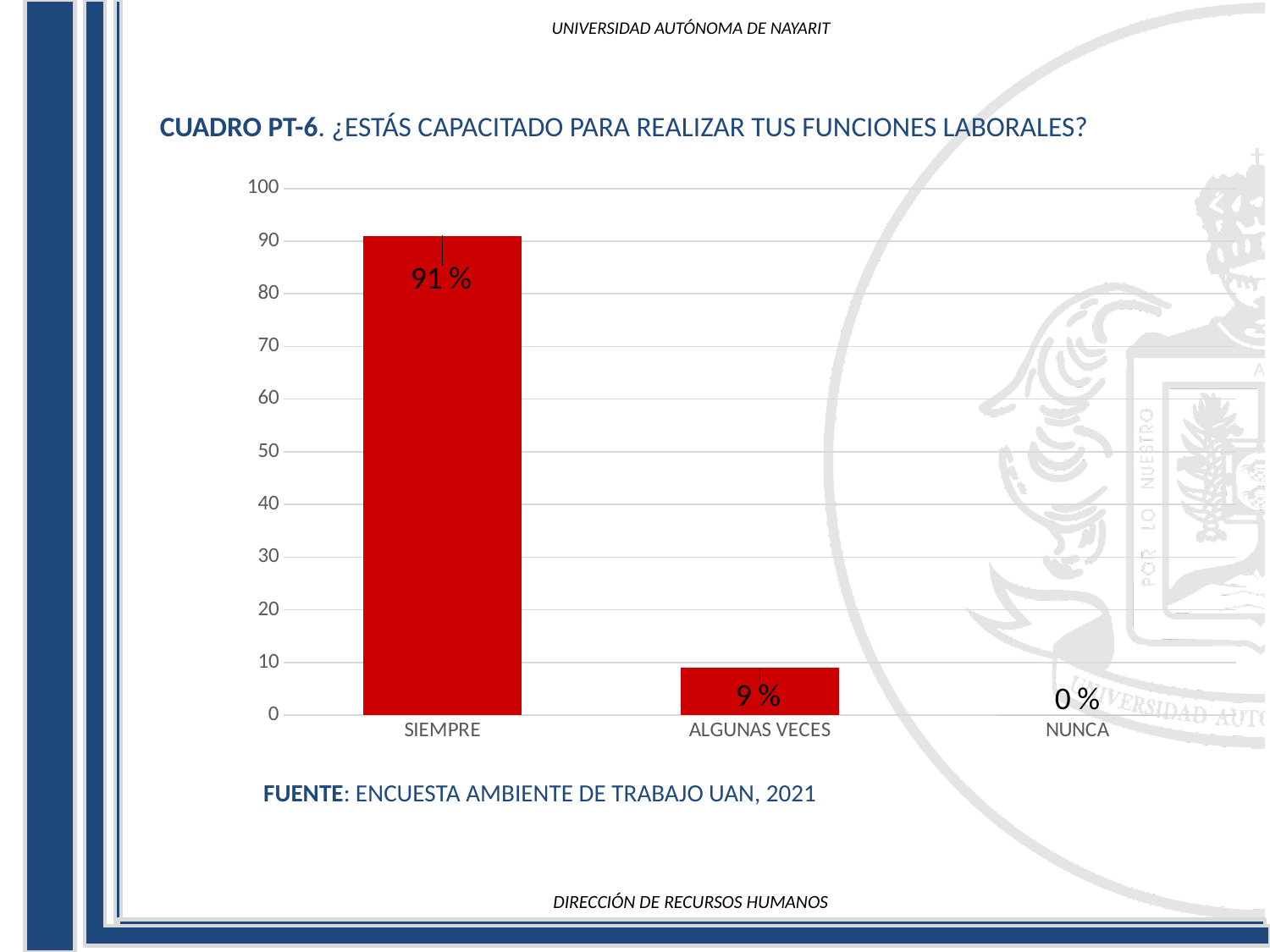
What is the value for ALGUNAS VECES? 9 % Do the values rise or fall from left to right along the x axis? fall How many categories are shown on the x axis? 3 What kind of chart is shown on the slide? bar chart What is the value for SIEMPRE? 91 % Which is larger, the value for ALGUNAS VECES or the value for NUNCA? ALGUNAS VECES What is the difference between the values for SIEMPRE and ALGUNAS VECES? 82 % Is the value for ALGUNAS VECES greater or less than 20? less Is the value for SIEMPRE greater or less than 50? greater Which category has the lowest value? NUNCA Which category has the highest value? SIEMPRE What is the value for NUNCA? 0 %